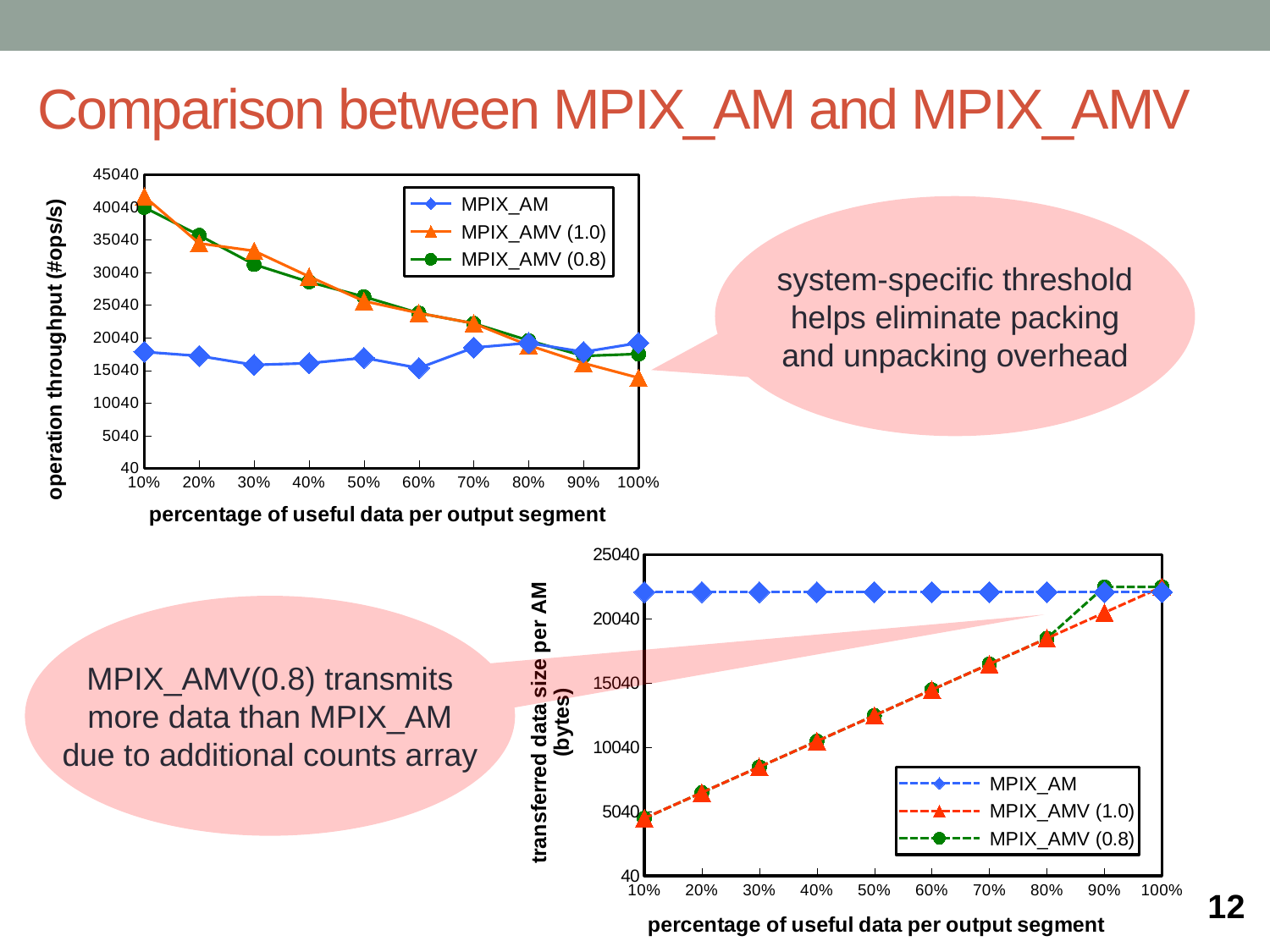
In the bottom chart (transferred data size per AM), which series has the higher value at 50%: MPIX_AM or MPIX_AMV (1.0)? MPIX_AM In the bottom chart (transferred data size per AM), is the value for MPIX_AMV (1.0) at 10% greater or less than 10040? less In the top chart (operation throughput), is the value for MPIX_AM at 60% greater or less than 20040? less What kind of chart is the bottom chart (transferred data size per AM)? line chart What is the x-axis label of the bottom chart? percentage of useful data per output segment In the top chart (operation throughput), which series has the higher value at 10%: MPIX_AM or MPIX_AMV (1.0)? MPIX_AMV (1.0) What kind of chart is the top chart (operation throughput)? line chart In the top chart (operation throughput), how many percentage points are shown along the x axis? 10 In the top chart (operation throughput), is the value for MPIX_AMV (1.0) at 10% greater or less than 35040? greater In the bottom chart (transferred data size per AM), does the MPIX_AMV (1.0) series rise or fall as the percentage of useful data increases? rise In the top chart (operation throughput), does the MPIX_AMV (1.0) series rise or fall as the percentage of useful data increases? fall In the top chart (operation throughput), how many series does the legend list? 3